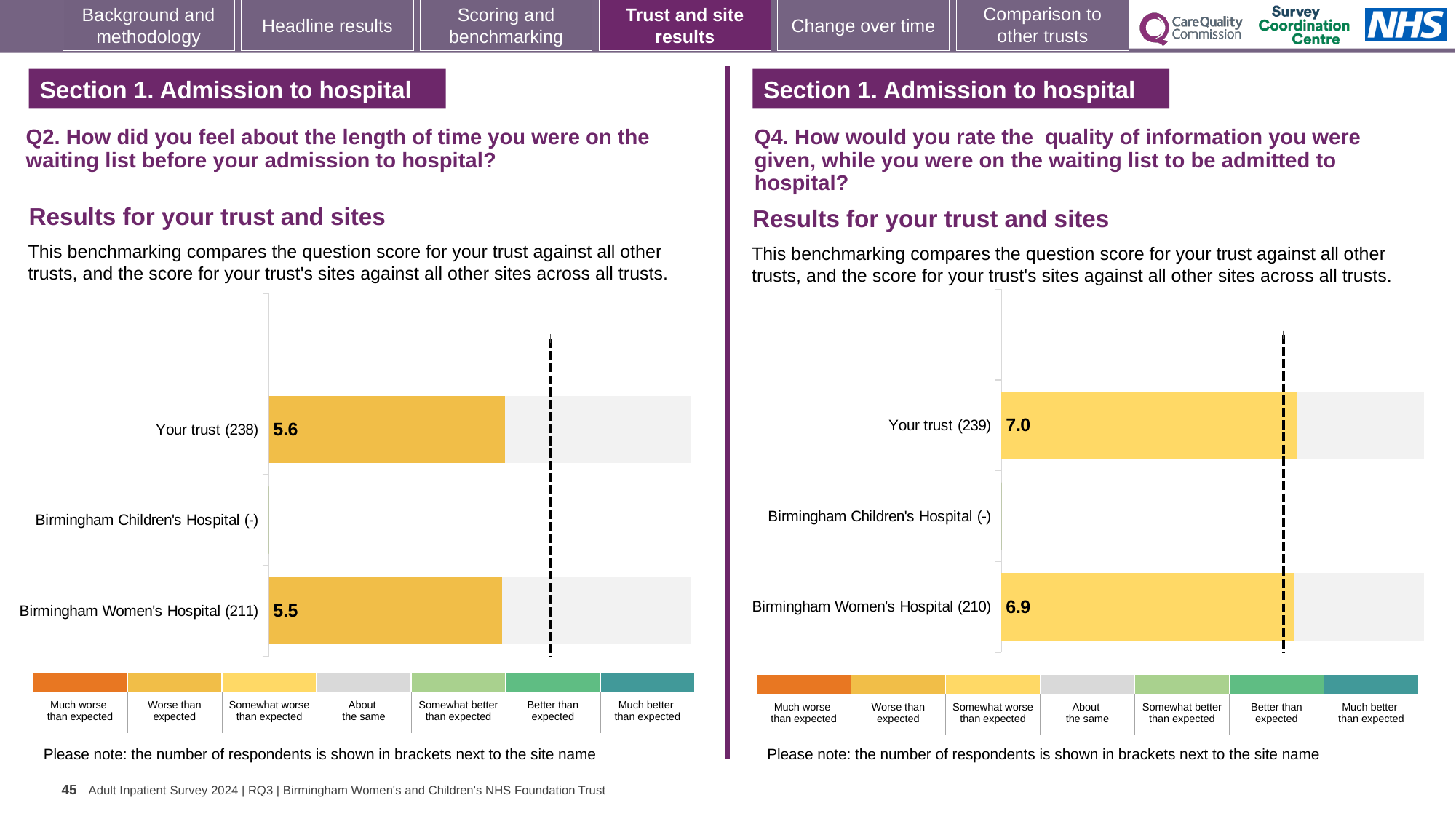
In the Q4 chart on the right, what is the difference between the score for Your trust (239) and the score for Birmingham Women's Hospital (210)? 0.1 In the Q4 chart on the right, what is the score for Birmingham Women's Hospital (210)? 6.9 What kind of chart is the Q4 chart on the right? Bar chart In the Q2 chart on the left, what is the score for Your trust (238)? 5.6 In the Q2 chart on the left, what is the score for Birmingham Women's Hospital (211)? 5.5 In the Q2 chart on the left, which site has no bar plotted? Birmingham Children's Hospital (-) In the Q2 chart on the left, which has the higher score: Your trust (238) or Birmingham Women's Hospital (211)? Your trust (238) In the Q4 chart on the right, what is the score for Your trust (239)? 7.0 In the Q2 chart on the left, what is the difference between the score for Your trust (238) and the score for Birmingham Women's Hospital (211)? 0.1 In the Q4 chart on the right, which has the higher score: Your trust (239) or Birmingham Women's Hospital (210)? Your trust (239) In the Q4 chart on the right, which benchmark category does the colour of the bars correspond to according to the legend? Somewhat worse than expected How many categories are listed on the vertical axis of the Q2 chart on the left? 3